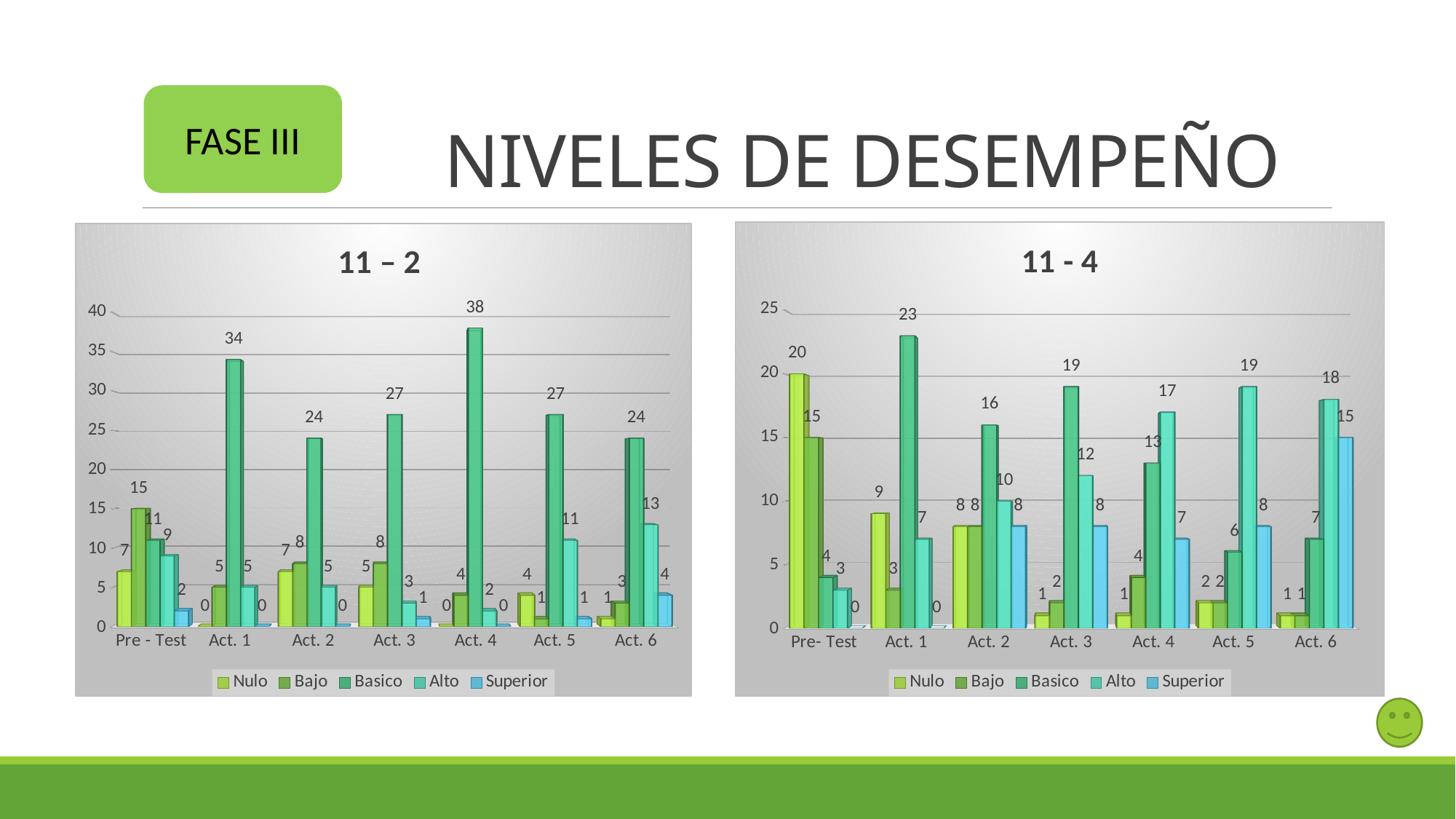
In the chart titled 11 – 4, which category has the highest Superior value? Act. 6 In the chart titled 11 – 2, how many categories are shown on the x axis? 7 How many series does the legend of the chart titled 11 – 4 list? 5 In the chart titled 11 – 2, what is the difference between the Basico values for Act. 1 and Act. 2? 10 In the chart titled 11 – 4, what is the value of Alto for Act. 5? 19 In the chart titled 11 – 4, which is larger for Act. 4: Basico or Alto? Alto In the chart titled 11 – 4, what is the value of Nulo for Pre- Test? 20 What kind of chart is the chart titled 11 – 2? Bar chart In the chart titled 11 – 2, what is the value of Basico for Act. 4? 38 In the chart titled 11 – 2, what is the value of Bajo for Pre - Test? 15 In the chart titled 11 – 2, which category has the highest Basico value? Act. 4 In the chart titled 11 – 4, what is the difference between the Basico values for Act. 1 and Act. 6? 16